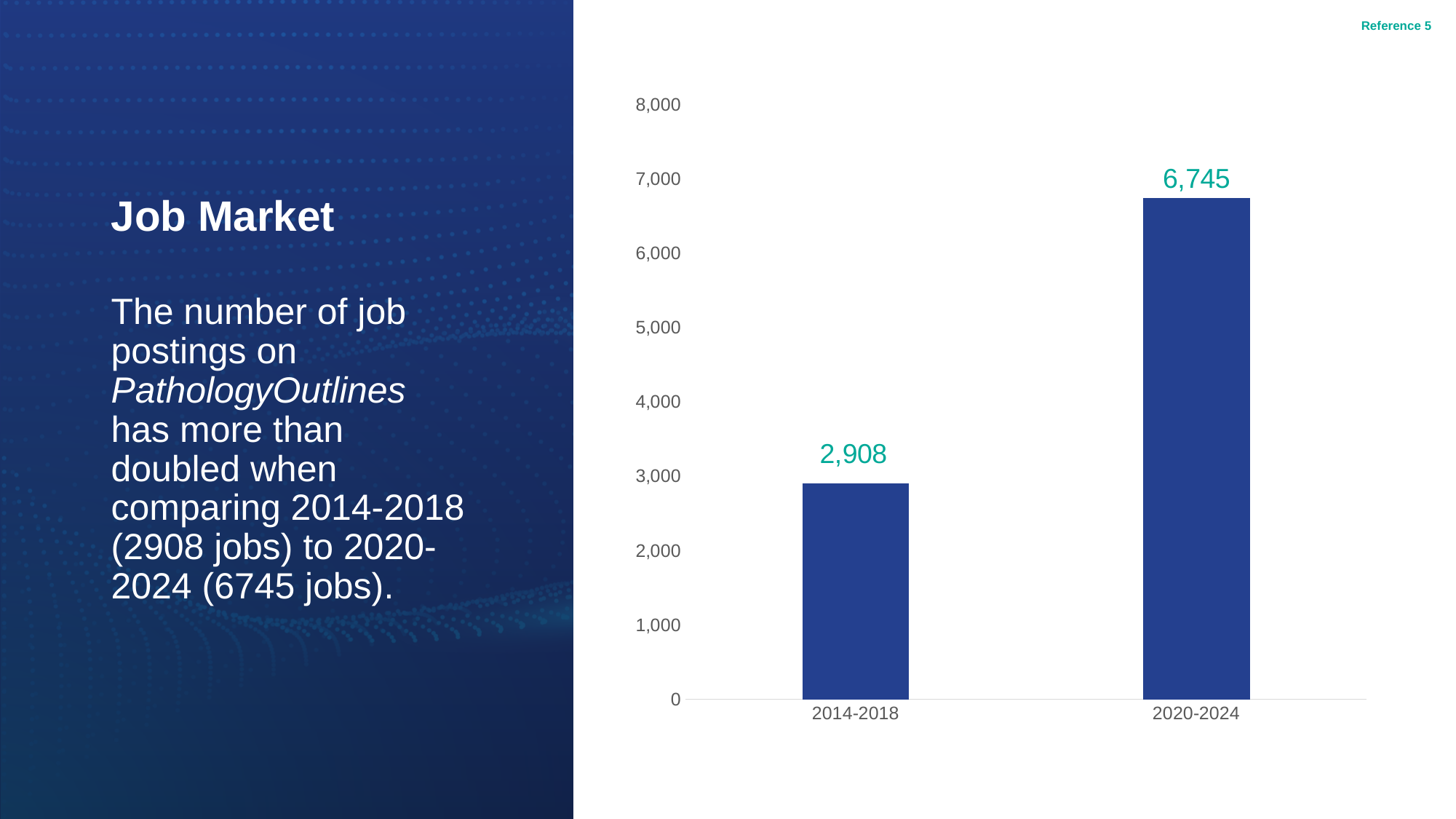
Which category has the lowest value? 2014-2018 What is the highest value shown on the vertical axis? 8,000 What kind of chart is shown on the slide? bar chart What is the value for 2020-2024? 6,745 How many categories are shown on the x axis? 2 Which is larger, the value for 2014-2018 or the value for 2020-2024? 2020-2024 Is the value for 2020-2024 greater or less than 6,000? greater What is the value for 2014-2018? 2,908 Do the values rise or fall from 2014-2018 to 2020-2024? rise Which category has the highest value? 2020-2024 What is the difference between the values for 2020-2024 and 2014-2018? 3,837 Is the value for 2014-2018 greater or less than 3,000? less